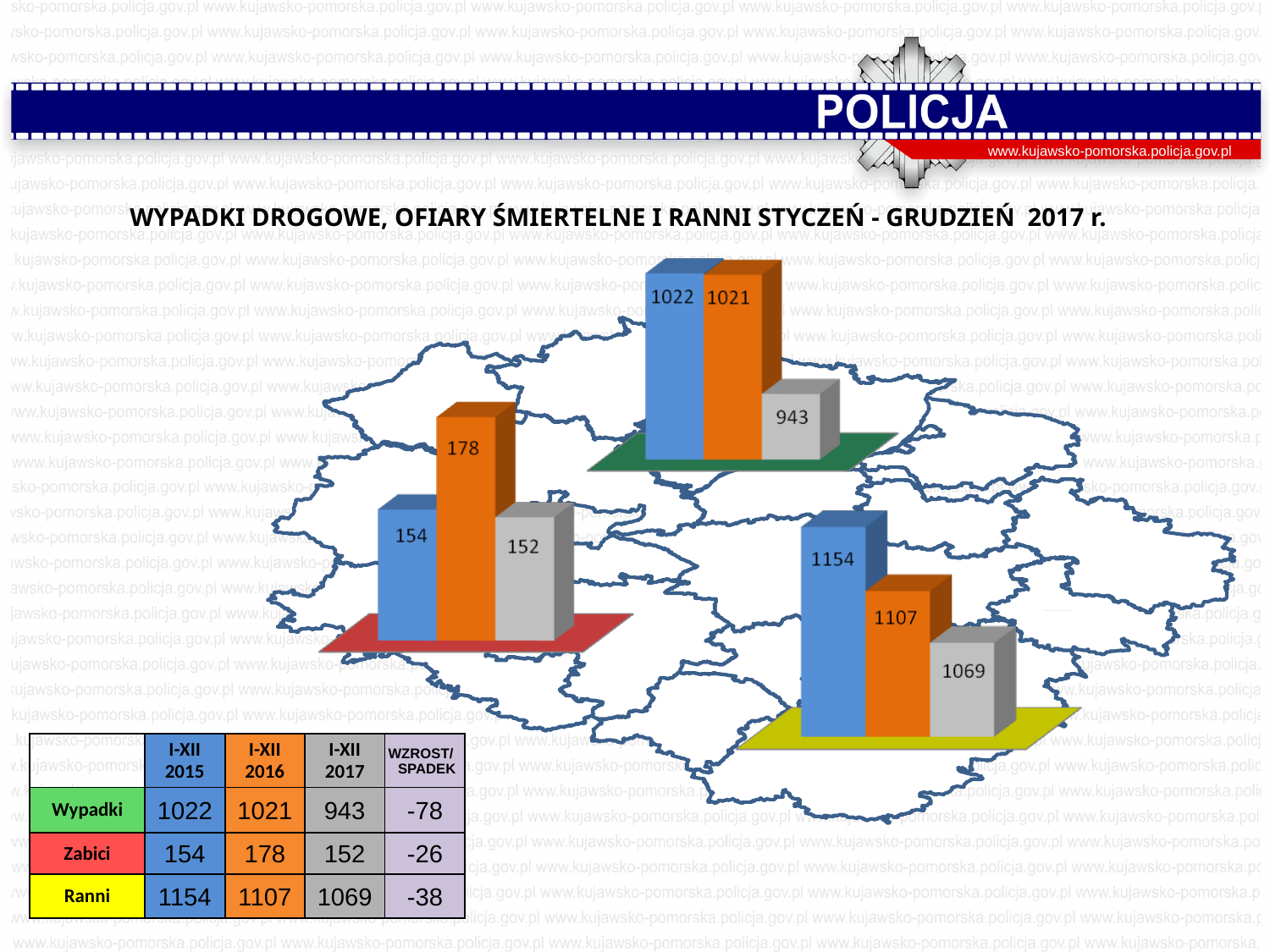
In the left chart (red base), which is larger: the blue bar or the grey bar? the blue bar (154) How many bars does the top chart (green base) contain? 3 In the bottom-right chart (yellow base), which bar has the lowest value? the grey bar (1069) In the bottom-right chart (yellow base), do the values rise or fall from the blue bar to the grey bar? fall What type of chart is the bottom-right chart (yellow base)? bar chart In the top chart (green base), what value is shown on the grey bar? 943 In the bottom-right chart (yellow base), what value is shown on the blue bar? 1154 In the bottom-right chart (yellow base), what is the difference between the blue bar (1154) and the orange bar (1107)? 47 In the left chart (red base), what value is shown on the orange bar? 178 In the top chart (green base), what value is shown on the blue bar? 1022 In the top chart (green base), what is the difference between the blue bar (1022) and the grey bar (943)? 79 In the left chart (red base), which bar has the highest value? the orange bar (178)